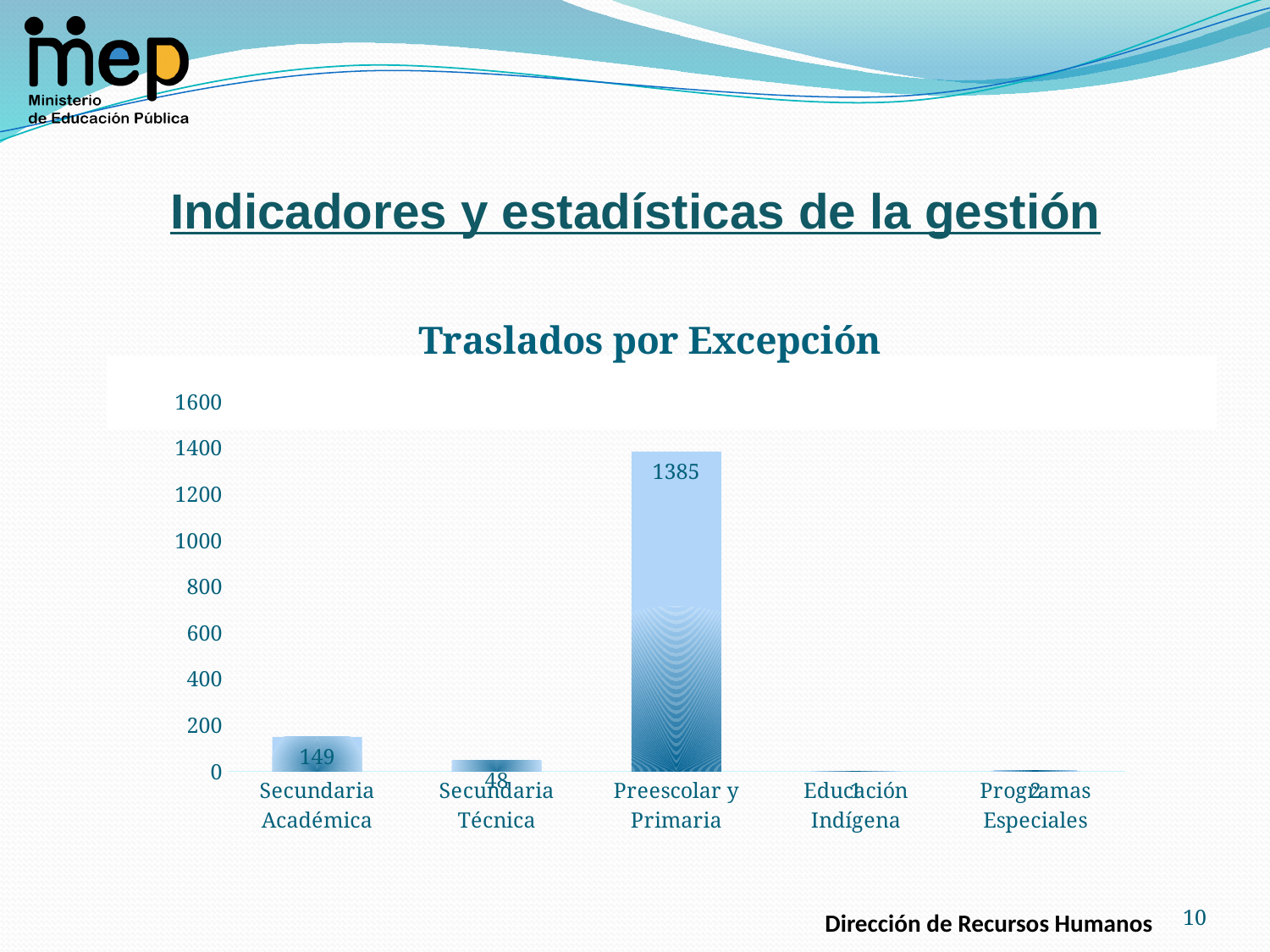
What is the value for Secundaria Técnica? 48 What is the value for Secundaria Académica? 149 Is the value for Preescolar y Primaria greater or less than 1200? greater Is the value for Educación Indígena greater or less than 200? less What is the difference between the values for Secundaria Académica and Secundaria Técnica? 101 How many categories are shown on the x axis? 5 What is the difference between the values for Preescolar y Primaria and Secundaria Académica? 1236 What is the value for Preescolar y Primaria? 1385 What kind of chart is shown? bar chart Which is larger, the value for Secundaria Académica or the value for Secundaria Técnica? Secundaria Académica Which category has the highest value? Preescolar y Primaria What is the title of the chart? Traslados por Excepción